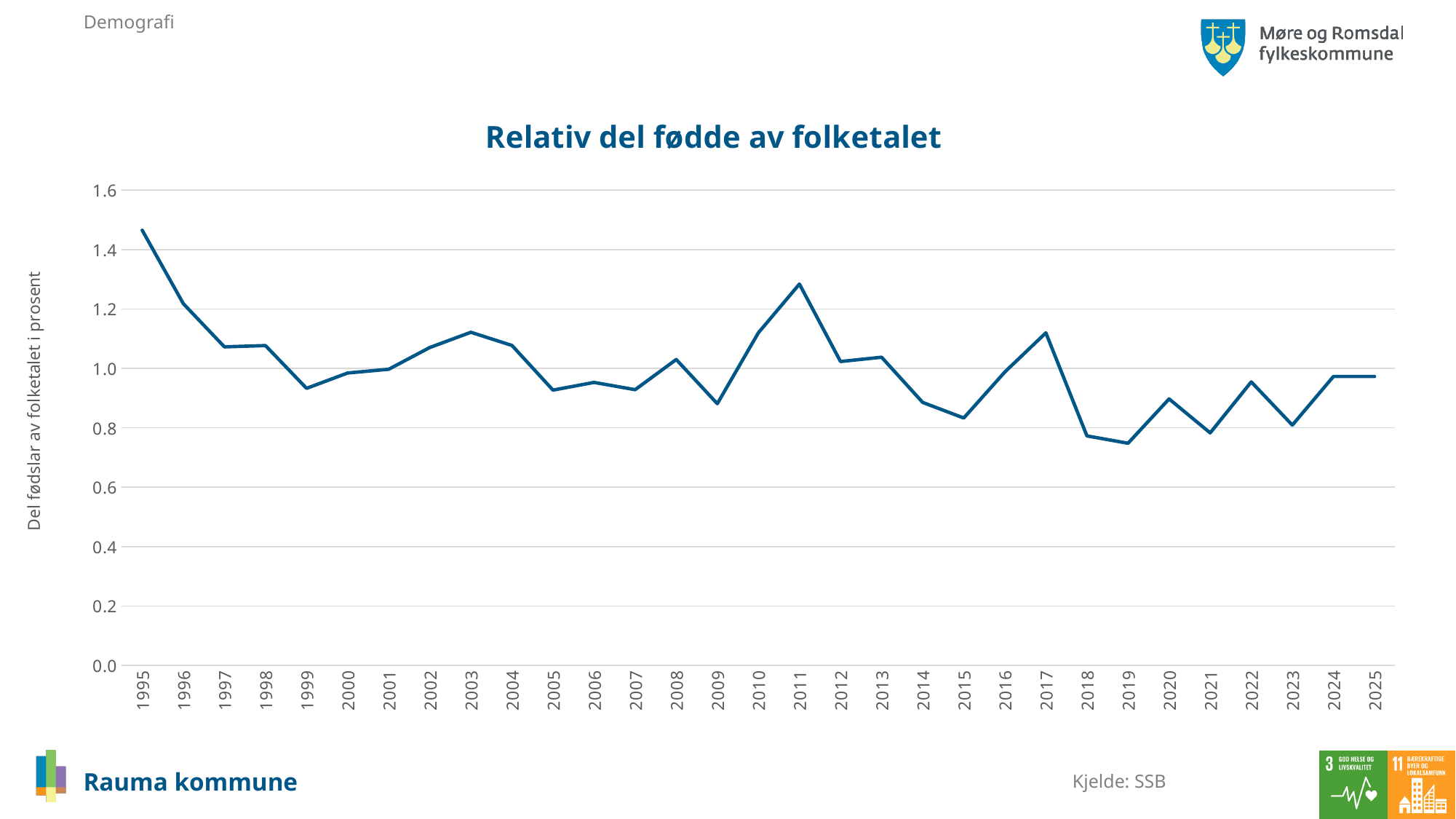
Overall, do the values rise or fall from 1995 to 2025? fall Is the value for 2009 greater or less than 1.0? less Which year has the larger value, 2011 or 2017? 2011 Is the value for 2011 greater or less than 1.2? greater How many years are plotted along the x axis of the chart? 31 What is the title of the chart? Relativ del fødde av folketalet What is the label on the vertical axis of the chart? Del fødslar av folketalet i prosent Is the value for 2017 greater or less than 1.0? greater Which year has the highest value in the chart? 1995 What kind of chart is shown on the slide? line chart